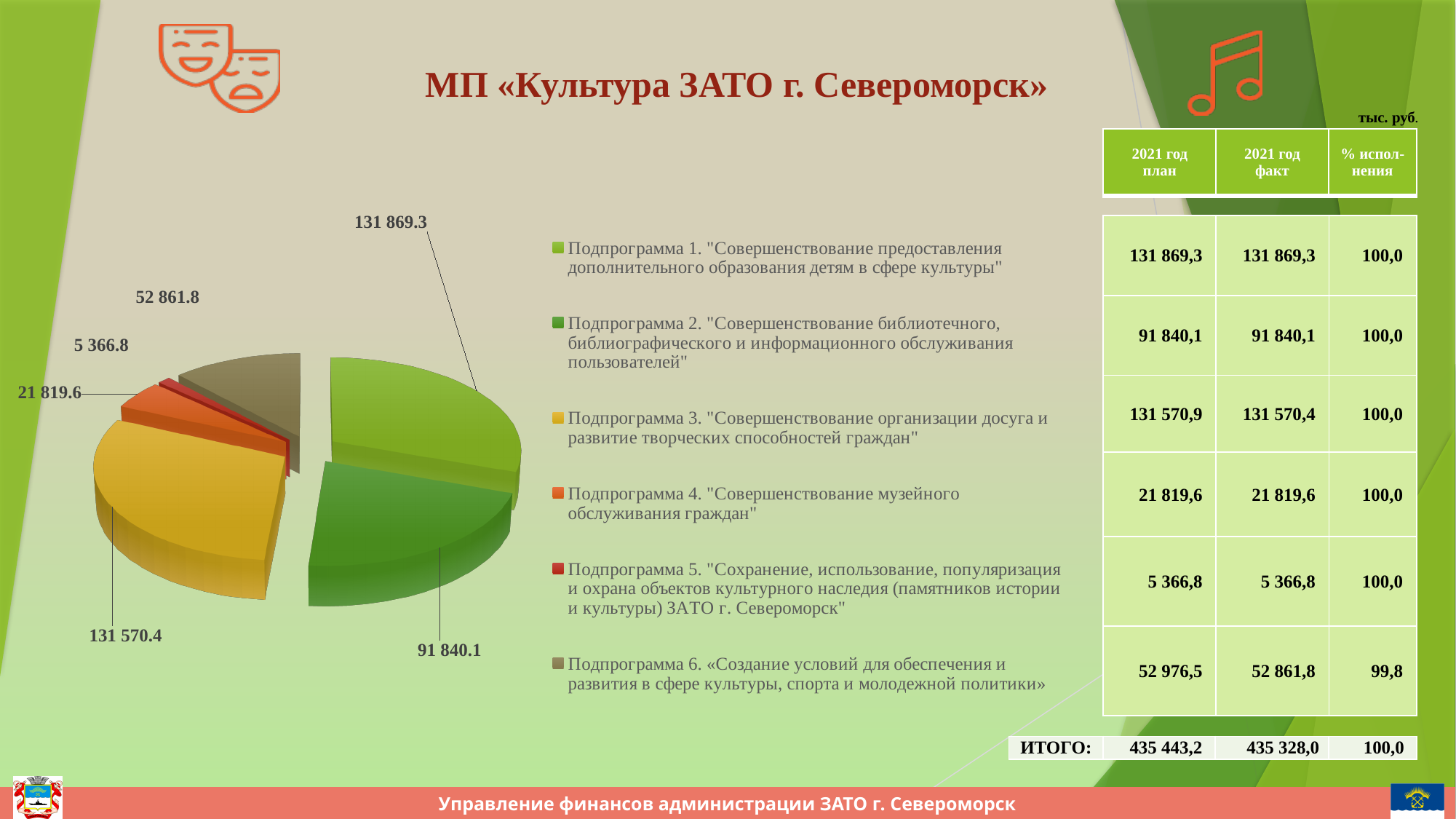
How many entries does the chart legend list? 6 Which is larger in the pie chart: Подпрограмма 2 or Подпрограмма 6? Подпрограмма 2 What is the value shown for Подпрограмма 6 in the pie chart? 52 861.8 How many slices does the pie chart have? 6 Which subprogram has the smallest slice in the pie chart? Подпрограмма 5 What is the value shown for Подпрограмма 1 in the pie chart? 131 869.3 What is the value shown for Подпрограмма 4 in the pie chart? 21 819.6 What is the difference between the values for Подпрограмма 4 and Подпрограмма 5 in the pie chart? 16 452.8 What is the difference between the values for Подпрограмма 2 and Подпрограмма 6 in the pie chart? 38 978.3 What colour is the slice for Подпрограмма 3 in the pie chart? yellow What kind of chart is shown on the slide? pie chart What is the value shown for Подпрограмма 2 in the pie chart? 91 840.1